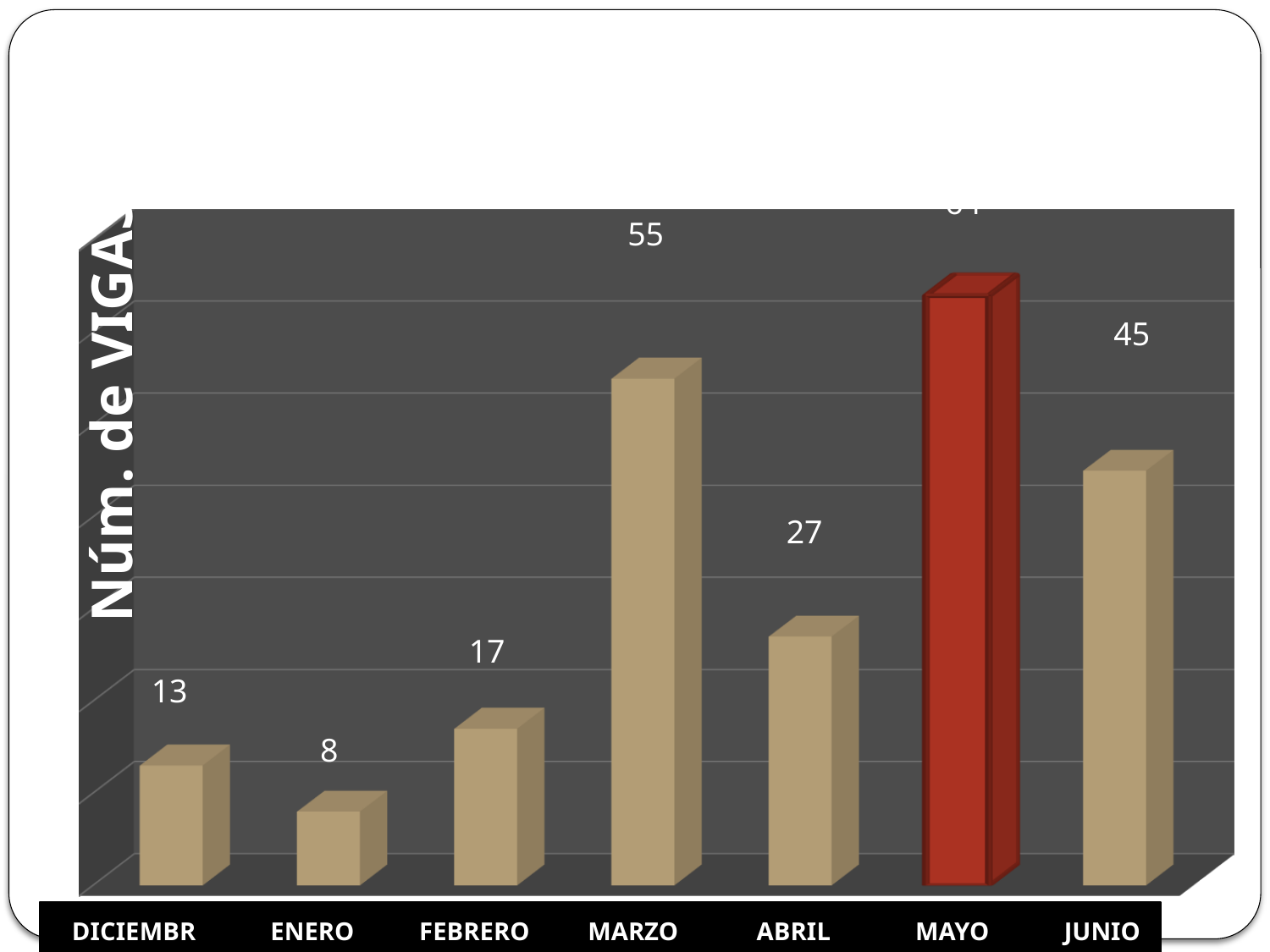
What is the value for DICIEMBR? 13 Which month has the lowest value? ENERO Which month has the highest bar? MAYO How many months are shown on the x axis? 7 What is the value for ABRIL? 27 Which is larger, the value for JUNIO or the value for MARZO? MARZO What is the difference between the values for MARZO and ABRIL? 28 What is the value for JUNIO? 45 What kind of chart is shown on the slide? bar chart Which month's bar is coloured red? MAYO What is the value for MARZO? 55 What is the value for ENERO? 8